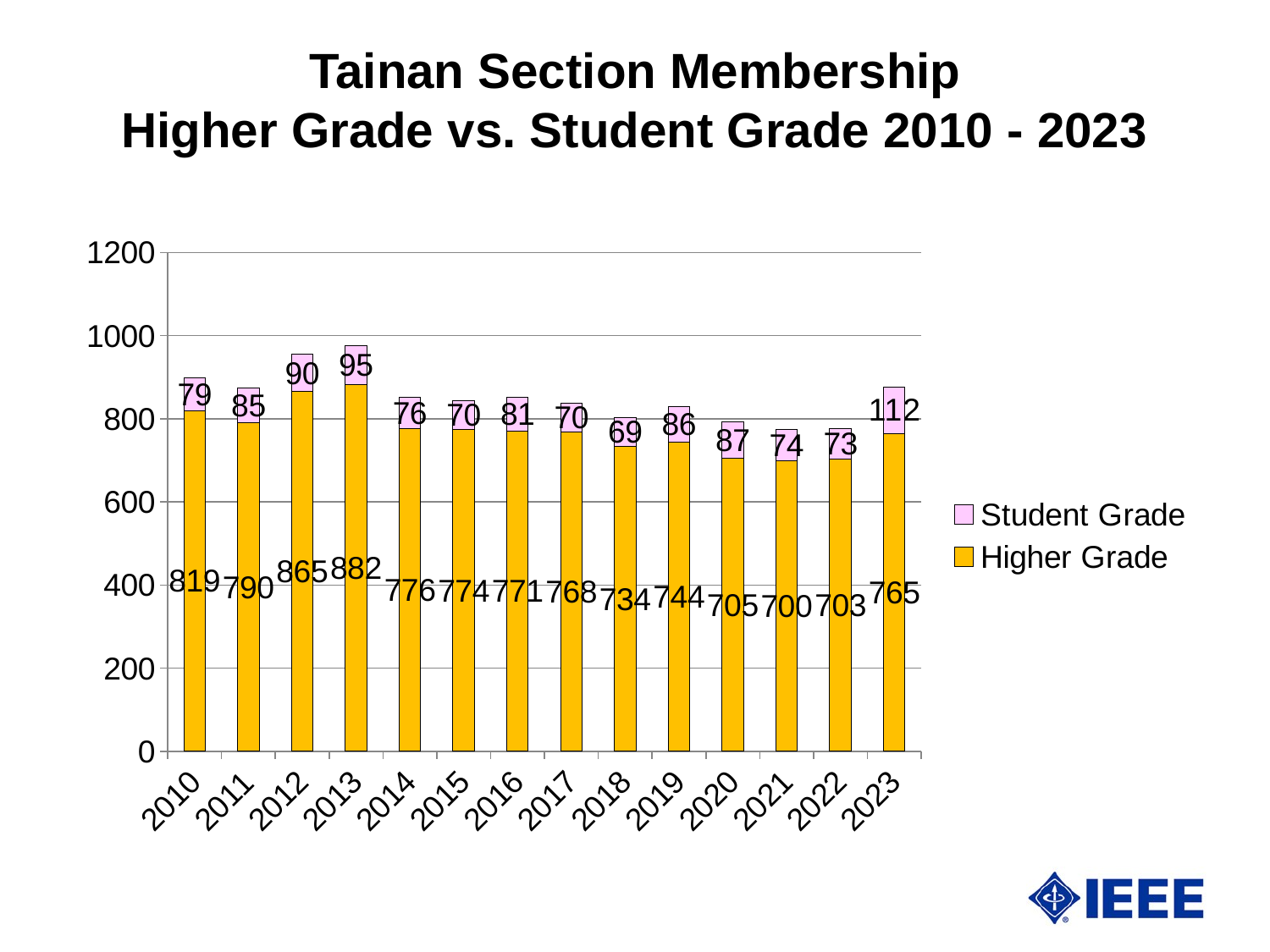
How many years are shown on the x axis? 14 What is the total membership (Higher Grade plus Student Grade) for 2023? 877 What is the Higher Grade membership value for 2018? 734 Which year has the lowest Higher Grade membership? 2021 Which year has the highest Higher Grade membership? 2013 What kind of chart is shown on the slide? Stacked bar chart How many series does the legend list? 2 What is the difference between the Higher Grade membership in 2013 and in 2021? 182 What is the Higher Grade membership value for 2013? 882 Which year has the highest Student Grade membership? 2023 Which is larger, the Higher Grade membership in 2012 or in 2019? 2012 What is the Student Grade membership value for 2023? 112